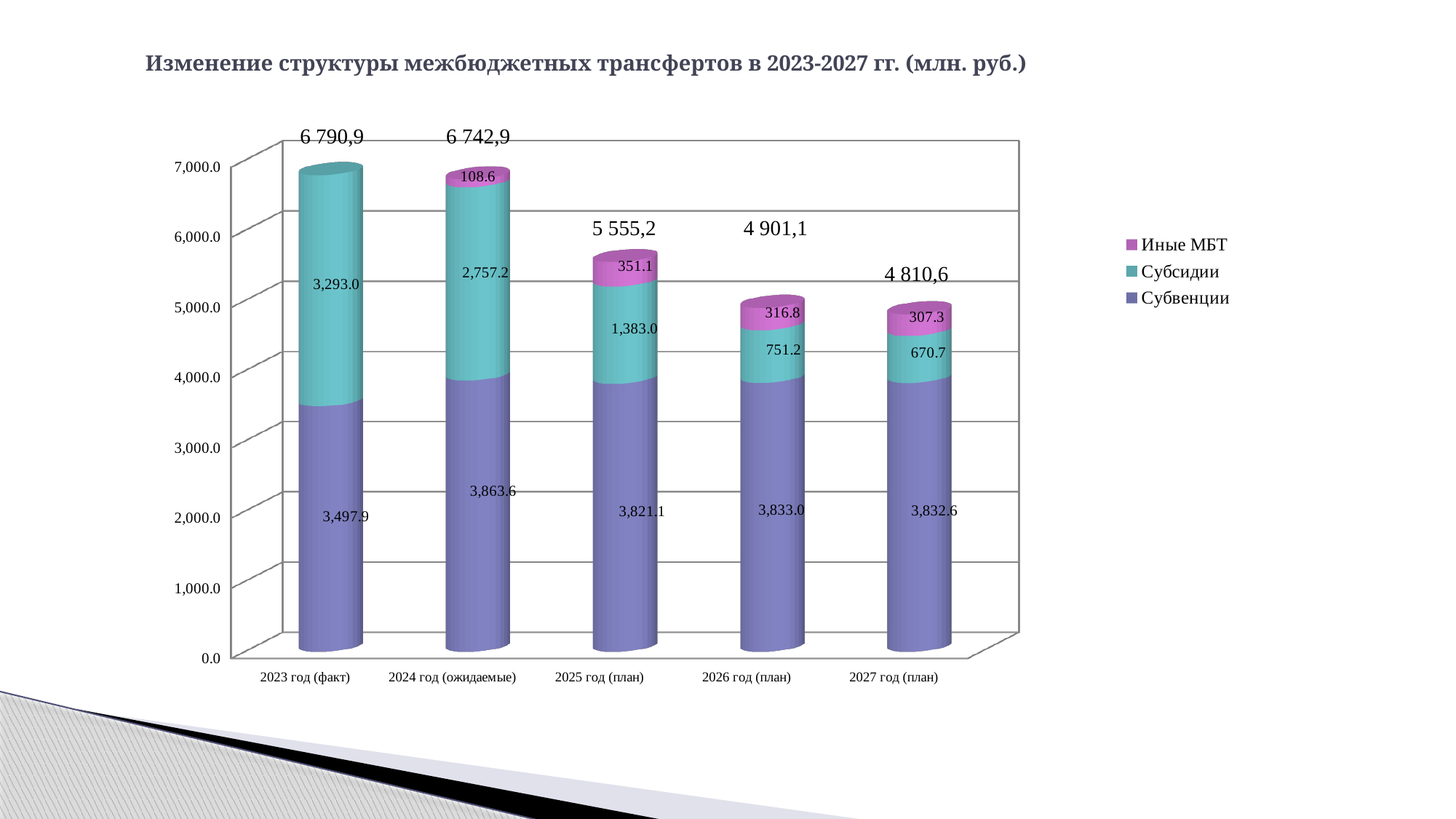
Which is larger: Субвенции for 2024 год (ожидаемые) or Субвенции for 2023 год (факт)? 2024 год (ожидаемые) Do the bar totals rise or fall from 2023 to 2027? Fall How many year categories are shown on the x axis? 5 Which year has the highest value of Субсидии? 2023 год (факт) What kind of chart is shown on the slide? Stacked bar chart Which year has the lowest value of Иные МБТ among the years where it is labelled? 2024 год (ожидаемые) What is the difference between the Субсидии values for 2024 год (ожидаемые) and 2025 год (план)? 1,374.2 What is the value of Субвенции for 2023 год (факт)? 3,497.9 What is the value of Иные МБТ for 2026 год (план)? 316.8 How many series does the legend list? 3 What is the value of Субсидии for 2025 год (план)? 1,383.0 What is the total labelled above the bar for 2027 год (план)? 4 810,6